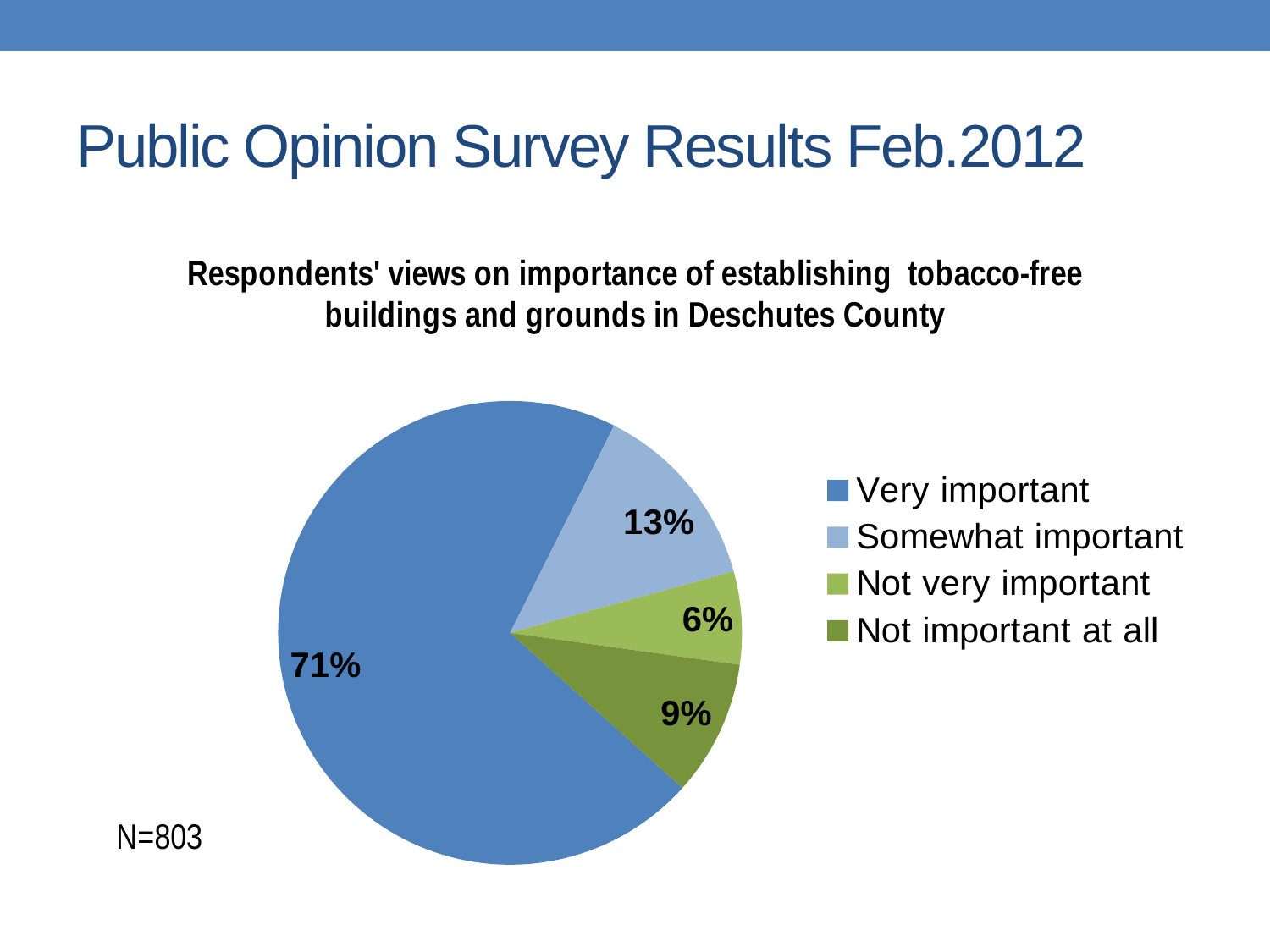
Which slice is larger: 'Not important at all' or 'Not very important'? Not important at all Which response category has the largest share of the pie? Very important What is the sample size (N) shown on the slide? 803 What percentage of respondents said it is not very important? 6% What is the combined percentage of respondents who said 'Not very important' or 'Not important at all'? 15% What percentage of respondents said it is somewhat important? 13% What type of chart is shown on the slide? Pie chart Which response category has the smallest share of the pie? Not very important What percentage of respondents said establishing tobacco-free buildings and grounds is very important? 71% What is the difference in percentage points between the 'Very important' and 'Somewhat important' slices? 58 How many response categories are shown in the pie chart? 4 What percentage of respondents said it is not important at all? 9%